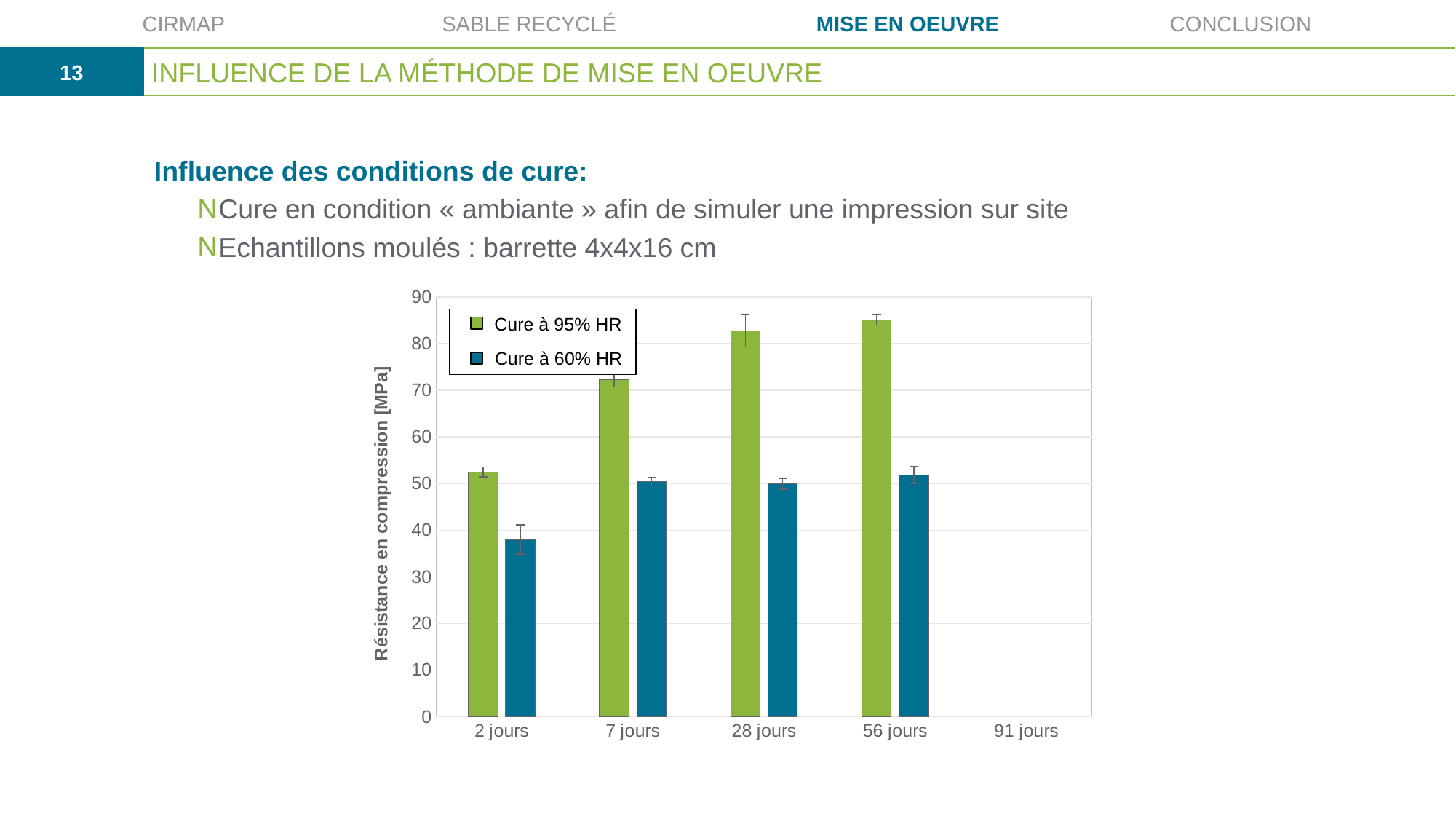
What are the two series named in the legend? Cure à 95% HR and Cure à 60% HR Is the value for Cure à 95% HR at 2 jours greater or less than 50? greater What is the label of the y axis? Résistance en compression [MPa] Does the Cure à 95% HR series rise or fall from 2 jours to 56 jours? rise Is the value for Cure à 95% HR at 7 jours greater or less than 70? greater At 2 jours, which series has the larger value, Cure à 95% HR or Cure à 60% HR? Cure à 95% HR How many series does the legend list? 2 How many categories are labelled on the x axis? 5 Is the value for Cure à 60% HR at 2 jours greater or less than 40? less For the Cure à 95% HR series, which category has the lowest value? 2 jours What kind of chart is shown on the slide? bar chart